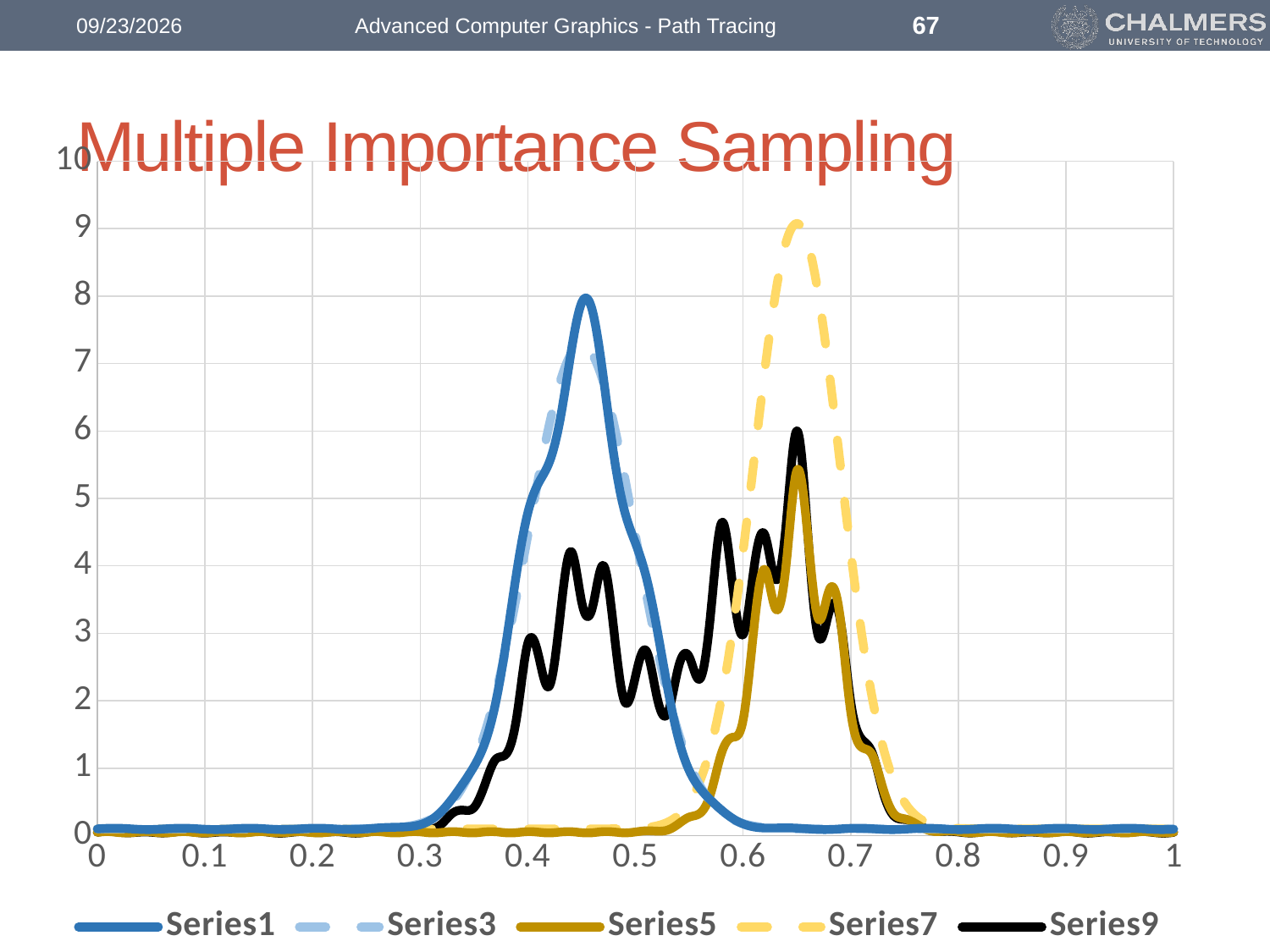
What kind of chart is shown on the slide? line chart Which series are drawn with dashed lines? Series3 and Series7 Is the peak value of Series1 greater or less than 7? greater Which series reaches the highest peak value? Series7 Which has a higher peak, Series1 or Series5? Series1 Is the value of Series5 at x = 0.9 greater or less than 1? less Is the peak value of Series9 greater or less than 5? greater Between x = 0.3 and x = 0.45, does Series1 rise or fall? rise How many series does the legend list? 5